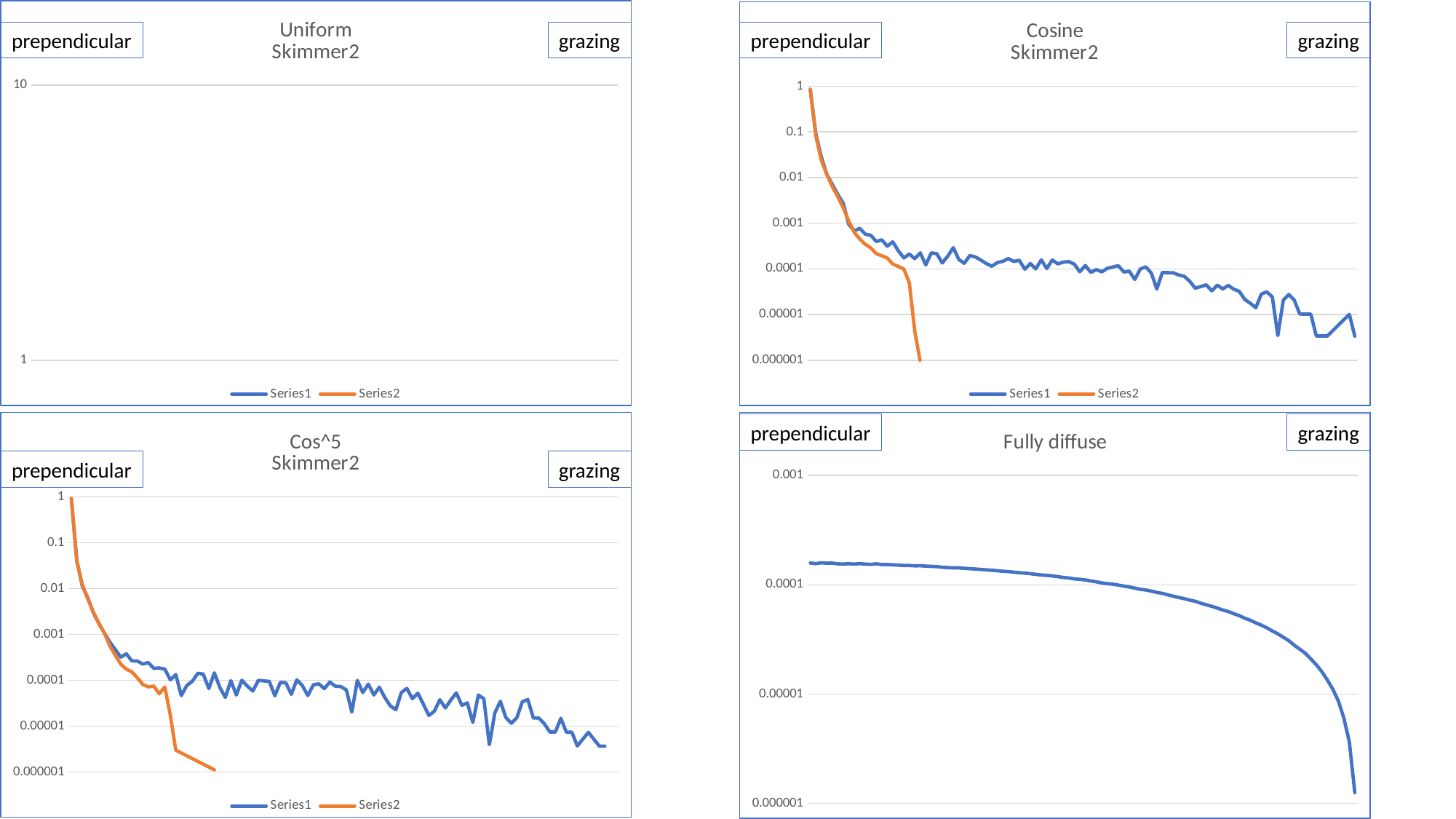
In the Fully diffuse chart, do the values rise or fall along the x axis? fall Which chart on the slide has no data plotted? Uniform Skimmer2 In the Cosine Skimmer2 chart, is the final value of Series2 greater or less than 0.00001? less In the Cosine Skimmer2 chart, do the Series2 values rise or fall along the x axis? fall In the Cos^5 Skimmer2 chart, how many series does the legend list? 2 What kind of chart is the Fully diffuse chart? line chart In the Cos^5 Skimmer2 chart, is the value of Series1 at the far right greater or less than 0.0001? less In the Cos^5 Skimmer2 chart, what colour is the Series2 line? orange In the Fully diffuse chart, is the value at the far left of the line greater or less than 0.0001? greater In the Cosine Skimmer2 chart, how many series does the legend list? 2